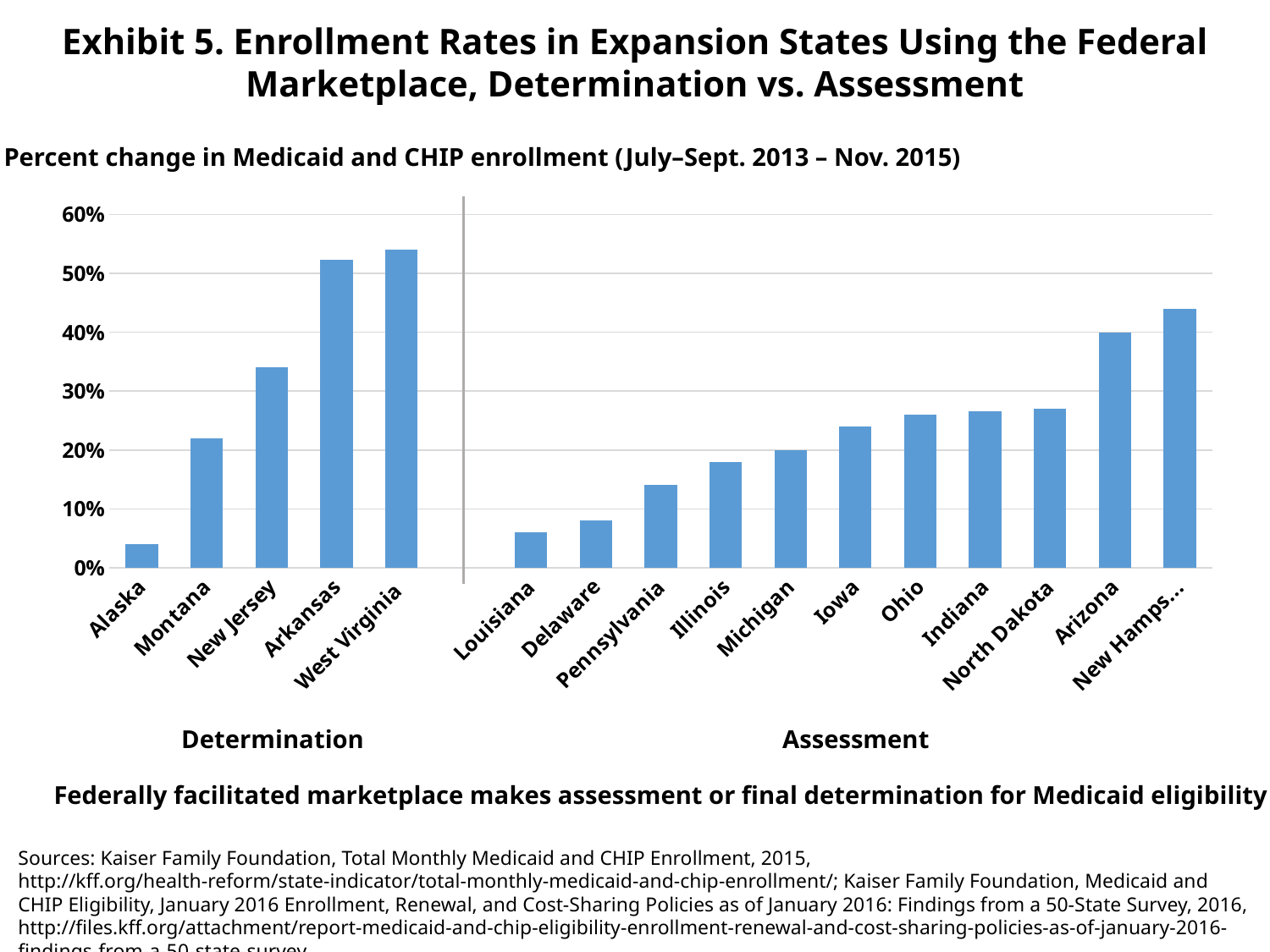
What is the title of the chart? Exhibit 5. Enrollment Rates in Expansion States Using the Federal Marketplace, Determination vs. Assessment How many states are in the Determination group? 5 Which state in the Assessment group has the highest enrollment rate? New Hampshire Is the value for Arkansas greater or less than 50%? greater How many states are in the Assessment group? 11 How many states are plotted in the chart? 16 Is the value for New Jersey greater or less than 30%? greater Which has a higher enrollment rate, Montana or Pennsylvania? Montana Which state in the Determination group has the lowest enrollment rate? Alaska Do the values in the Assessment group rise or fall from Louisiana to New Hampshire? rise What kind of chart is shown on the slide? bar chart Is the value for Louisiana greater or less than 10%? less